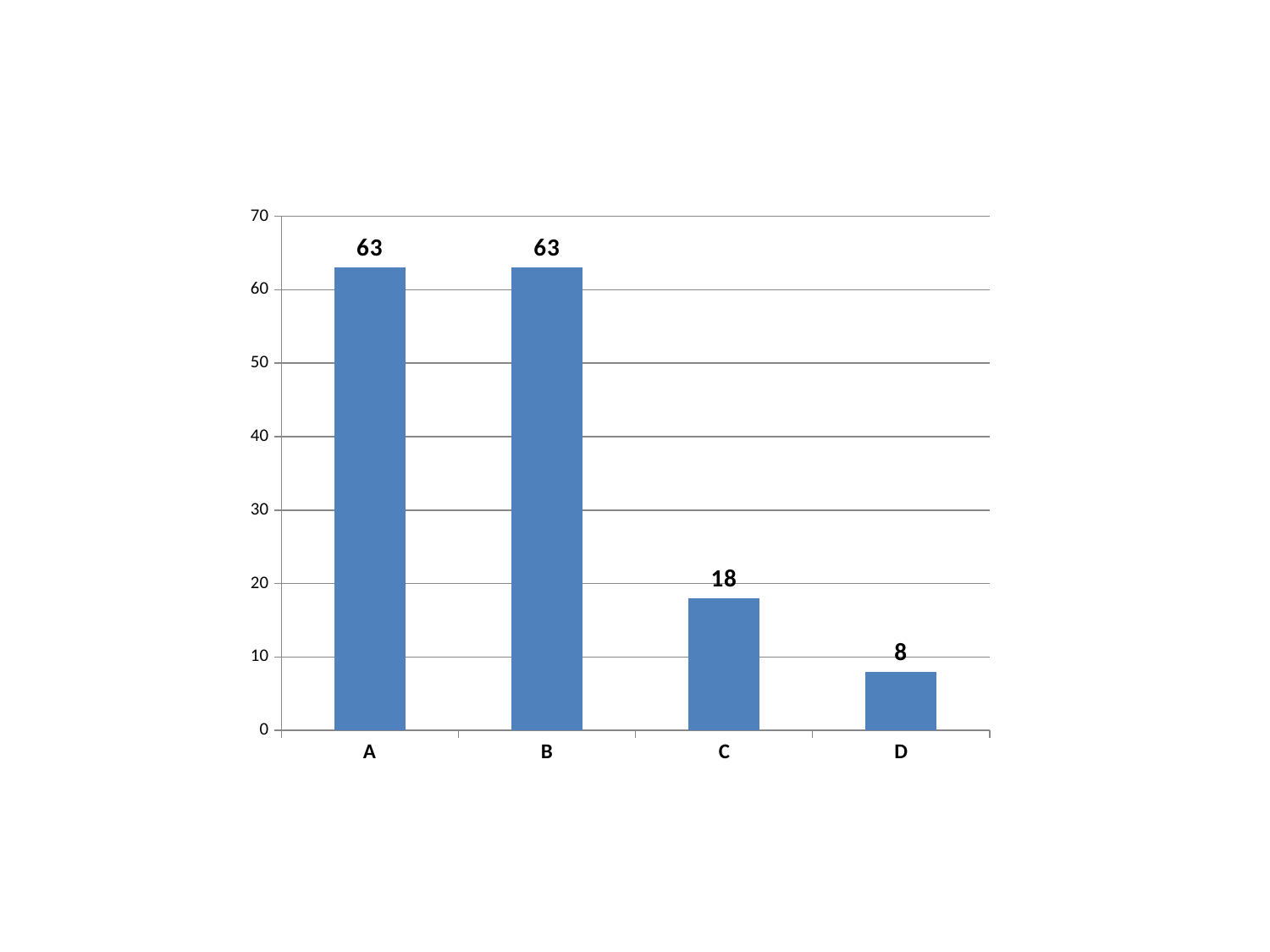
Which category has the lowest value? D Is the value for C greater or less than 20? less How many categories are shown on the x axis? 4 Which is larger, the value for C or the value for D? C What is the value for category A? 63 Do the values rise or fall from category B to category D? fall What is the value for category B? 63 What is the difference between the values for C and D? 10 What is the value for category C? 18 What is the difference between the values for A and C? 45 What is the value for category D? 8 What kind of chart is shown on the slide? bar chart